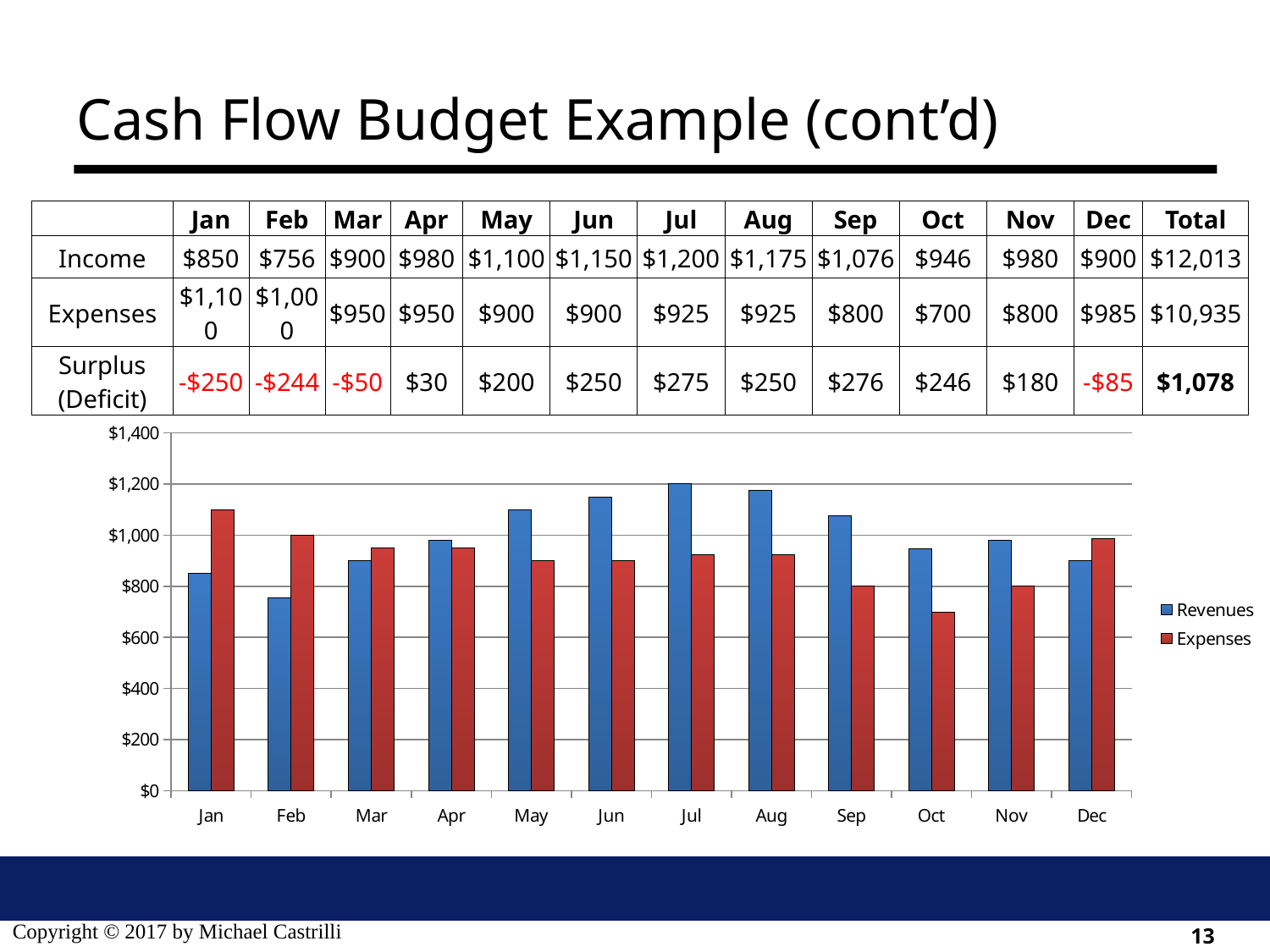
Which month has the lowest Revenues bar in the chart? Feb Which month has the highest Expenses bar in the chart? Jan What kind of chart is shown on the slide? bar chart Is the Expenses value for Oct greater or less than $800? less How many months are shown along the x axis of the chart? 12 In Sep, which is larger in the chart, Revenues or Expenses? Revenues What are the two legend entries of the chart? Revenues and Expenses Which month has the lowest Expenses bar in the chart? Oct How many series does the chart legend list? 2 Which month has the highest Revenues bar in the chart? Jul Is the Revenues value for Jan greater or less than $1,000? less Do the Revenues bars rise or fall from Feb to Jul? rise